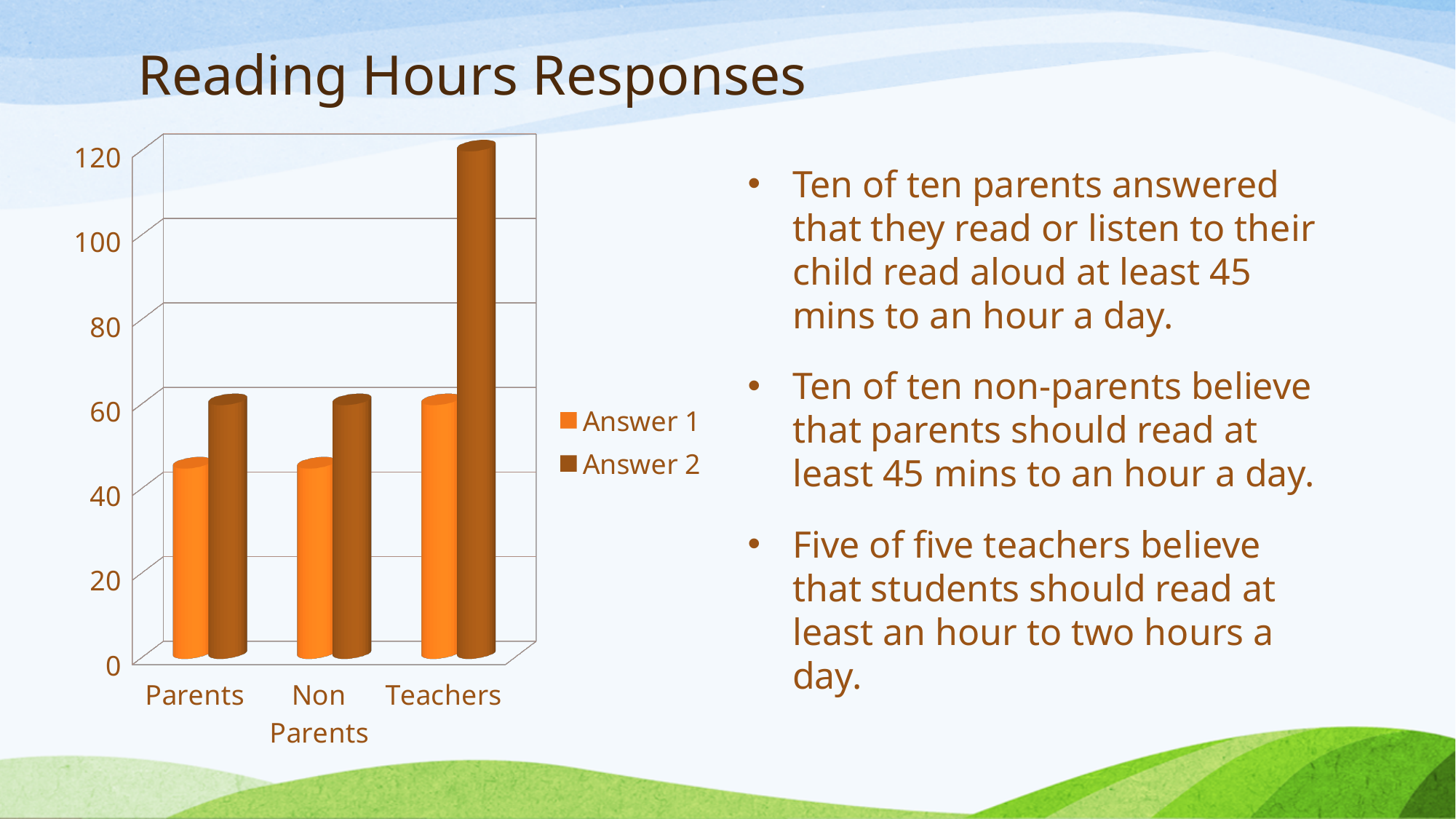
Is the Answer 2 value for Non Parents greater or less than 40? greater Which category has the highest value for Answer 1? Teachers How many series does the chart's legend list? 2 What kind of chart is shown on the slide? bar chart For Parents, which series has the larger value, Answer 1 or Answer 2? Answer 2 What are the two entries in the chart's legend? Answer 1 and Answer 2 Is the Answer 1 value for Parents greater or less than 60? less Which is larger: the Answer 2 value for Teachers or the Answer 2 value for Parents? Teachers Is the Answer 2 value for Teachers greater or less than 100? greater What is the title of the slide containing the chart? Reading Hours Responses How many categories are shown on the x axis of the chart? 3 Which category has the highest value for Answer 2? Teachers